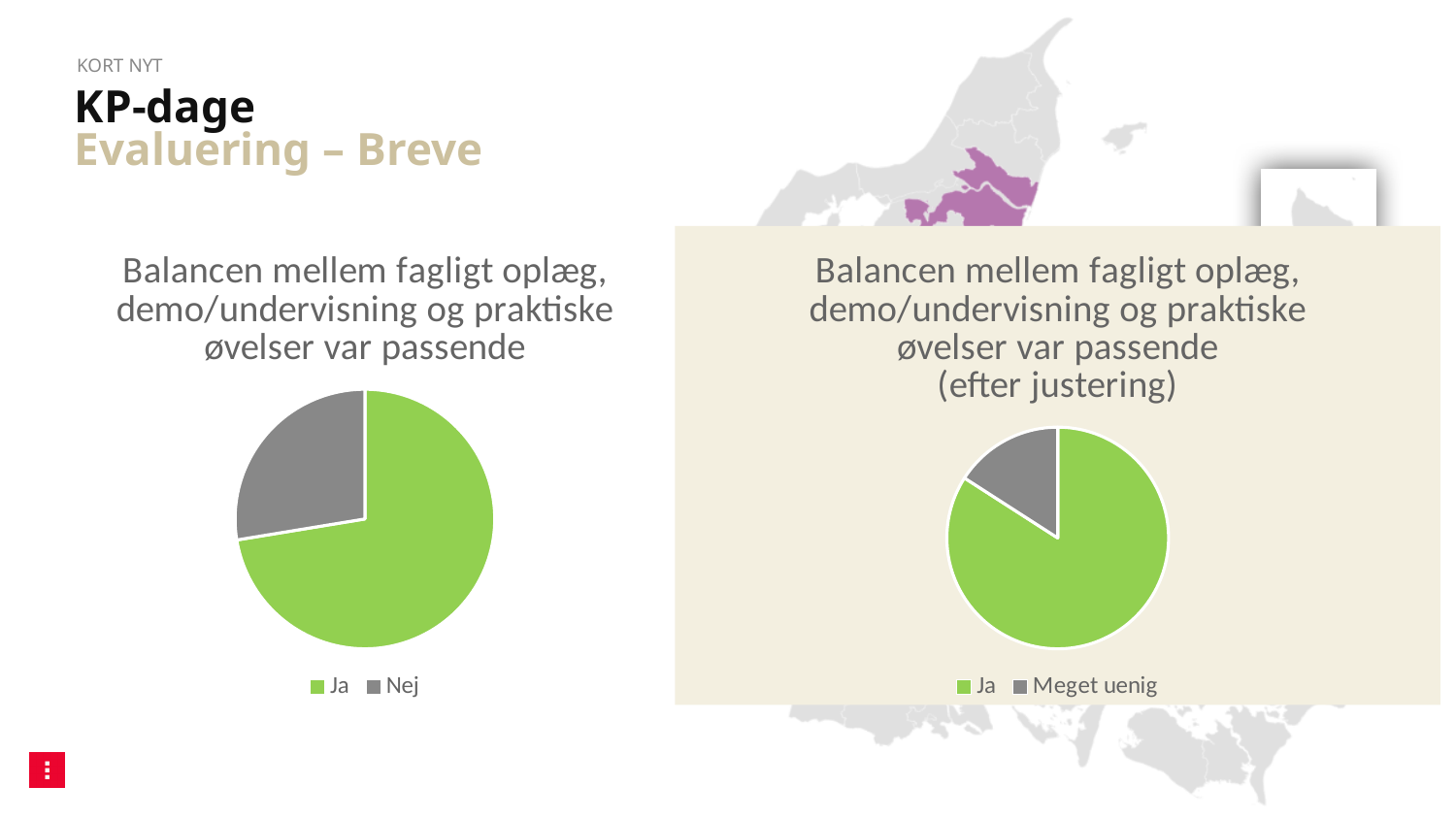
In the left pie chart, which category has the largest slice? Ja What kind of chart is the left chart titled 'Balancen mellem fagligt oplæg, demo/undervisning og praktiske øvelser var passende'? Pie chart How many slices does the right pie chart (efter justering) have? 2 In the right pie chart (efter justering), which category has the smallest slice? Meget uenig In the right pie chart (efter justering), is the slice for 'Meget uenig' larger or smaller than the slice for 'Ja'? Smaller In the left pie chart, which category has the smallest slice? Nej In the left pie chart, what colour is the 'Ja' slice? Green In the left pie chart, is the slice for 'Ja' larger or smaller than the slice for 'Nej'? Larger In the right pie chart (efter justering), which category has the largest slice? Ja How many categories does the legend of the left pie chart list? 2 What are the legend entries of the right pie chart (efter justering)? Ja, Meget uenig What kind of chart is the right chart titled 'Balancen mellem fagligt oplæg, demo/undervisning og praktiske øvelser var passende (efter justering)'? Pie chart